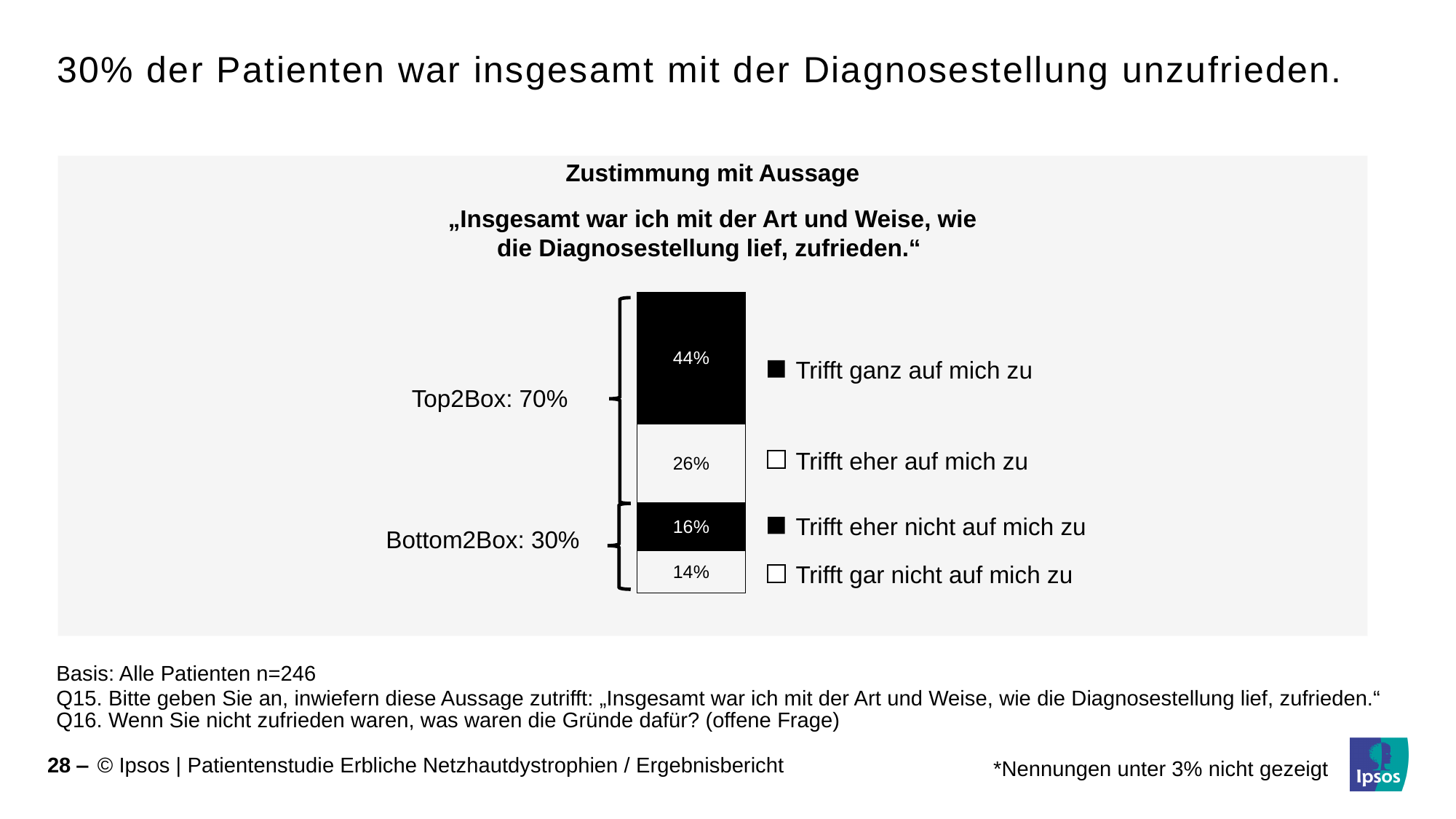
What kind of chart is shown on the slide? Stacked bar chart What percentage of patients answered "Trifft ganz auf mich zu"? 44% What percentage of patients answered "Trifft gar nicht auf mich zu"? 14% Which response category has the lowest share? Trifft gar nicht auf mich zu Which response category has the highest share? Trifft ganz auf mich zu What percentage of patients answered "Trifft eher nicht auf mich zu"? 16% What percentage of patients answered "Trifft eher auf mich zu"? 26% What is the Top2Box value shown on the chart? 70% How many response categories does the legend list? 4 Which is larger: the share for "Trifft eher nicht auf mich zu" or for "Trifft gar nicht auf mich zu"? Trifft eher nicht auf mich zu What is the Bottom2Box value shown on the chart? 30% What is the difference between the shares for "Trifft ganz auf mich zu" and "Trifft eher auf mich zu"? 18%